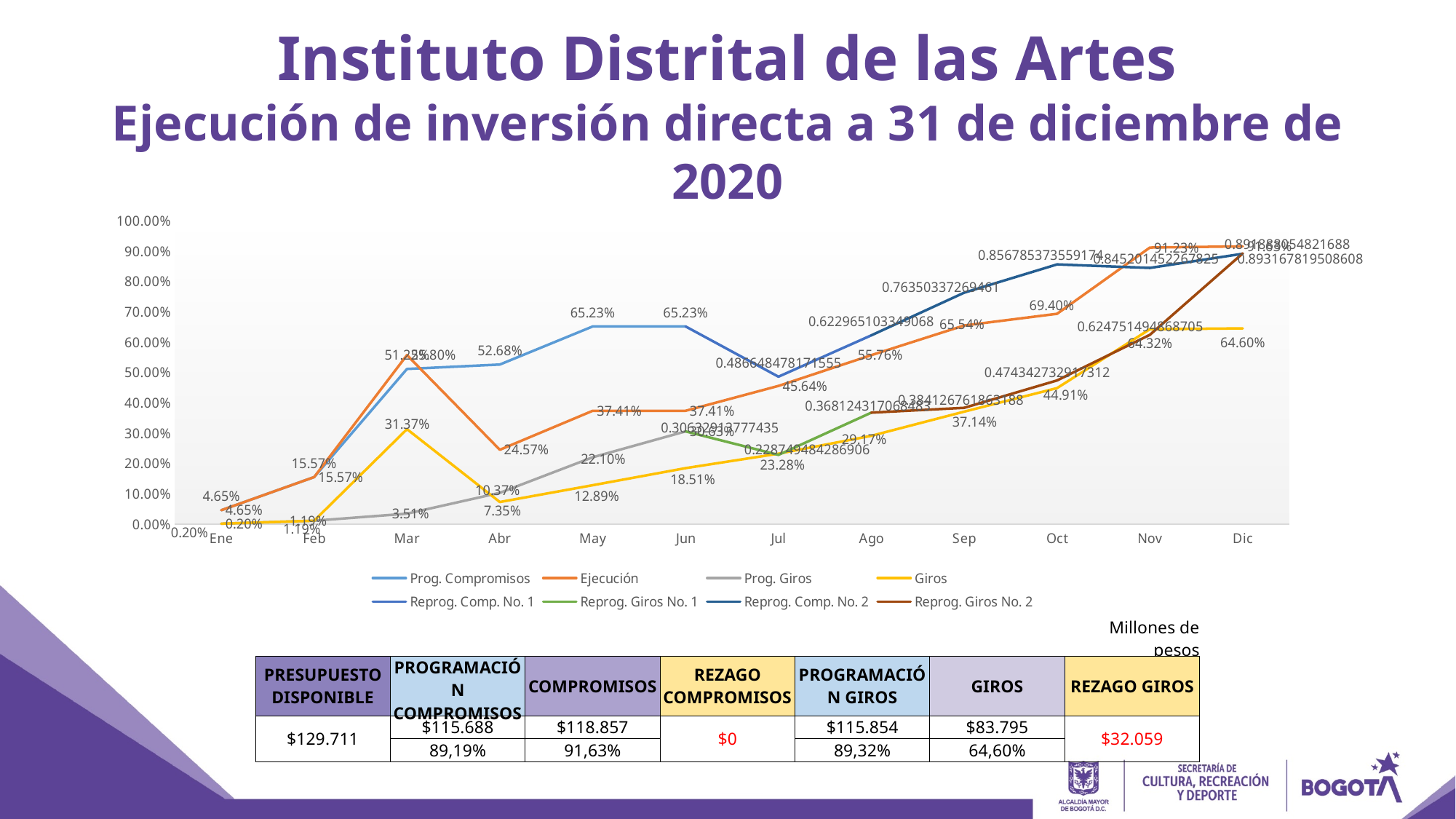
What is the value of Ejecución in Oct? 69.40% What kind of chart is shown on the slide? Line chart What is the difference between Ejecución (91.23%) and Giros (64.32%) in Nov? 26.91% What is the value of Prog. Giros in May? 22.10% What is the value of Giros in Mar? 31.37% What is the value of Giros in Dic? 64.60% How many months are shown on the x axis of the chart? 12 Is the value for Reprog. Comp. No. 2 in Oct greater or less than 80%? greater In which month is Giros lowest? Ene How many series does the chart legend list? 8 What is the value of Prog. Compromisos in May? 65.23% In Abr, which is larger: Ejecución or Giros? Ejecución